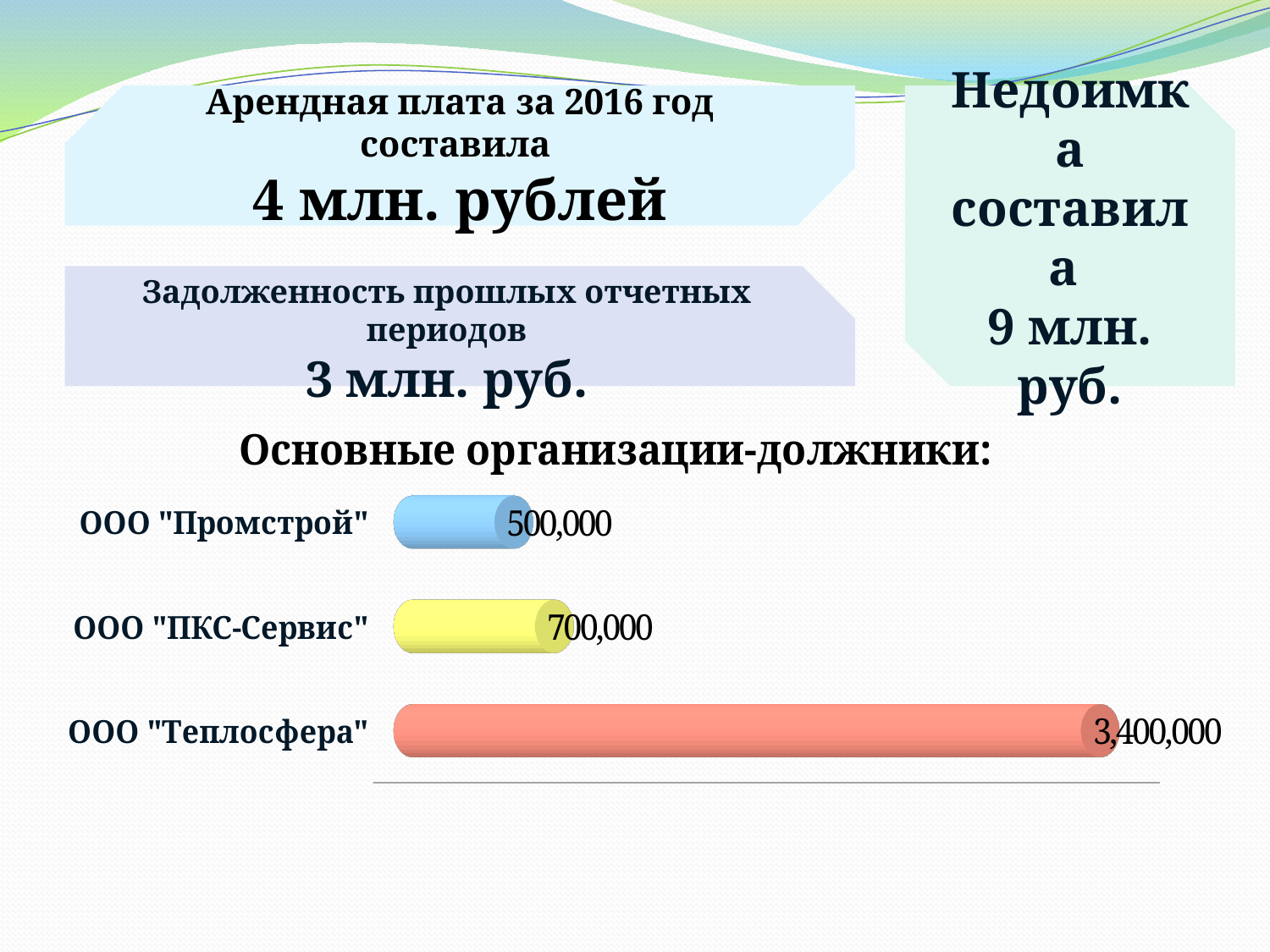
Which is larger, the value for ООО "ПКС-Сервис" or ООО "Промстрой"? ООО "ПКС-Сервис" What is the value for ООО "Теплосфера"? 3,400,000 What is the value for ООО "ПКС-Сервис"? 700,000 What is the value for ООО "Промстрой"? 500,000 What is the title above the chart? Основные организации-должники: What colour is the bar for ООО "Теплосфера"? salmon (orange-red) What is the difference between the values for ООО "ПКС-Сервис" and ООО "Промстрой"? 200,000 Which organization has the highest value? ООО "Теплосфера" What kind of chart is shown on the slide? bar chart How many organizations are shown in the chart? 3 Which organization has the lowest value? ООО "Промстрой" What is the difference between the values for ООО "Теплосфера" and ООО "ПКС-Сервис"? 2,700,000